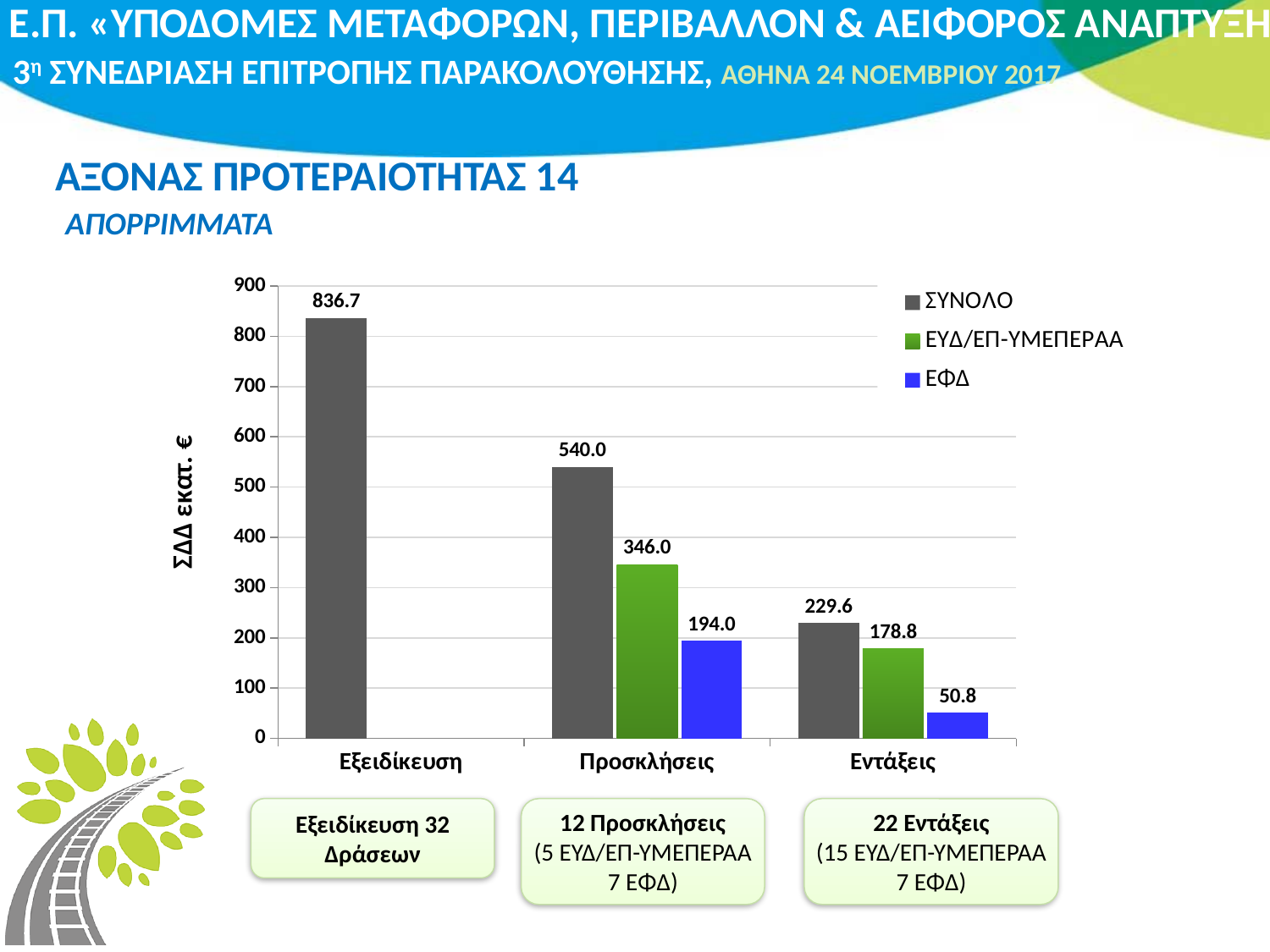
Which is larger: the ΕΥΔ/ΕΠ-ΥΜΕΠΕΡΑΑ value for Προσκλήσεις or the ΕΦΔ value for Προσκλήσεις? ΕΥΔ/ΕΠ-ΥΜΕΠΕΡΑΑ How many series does the legend list? 3 How many categories are shown on the x axis? 3 Is the ΣΥΝΟΛΟ value for Εντάξεις greater or less than 300? less What is the ΕΥΔ/ΕΠ-ΥΜΕΠΕΡΑΑ value for Προσκλήσεις? 346.0 Which category has the lowest ΕΦΔ value? Εντάξεις What kind of chart is shown on the slide? bar chart What is the difference between the ΣΥΝΟΛΟ values for Προσκλήσεις and Εντάξεις? 310.4 What is the label of the y axis? ΣΔΔ εκατ. € What is the ΣΥΝΟΛΟ value for Εξειδίκευση? 836.7 Which category has the highest ΣΥΝΟΛΟ value? Εξειδίκευση What is the ΕΦΔ value for Εντάξεις? 50.8